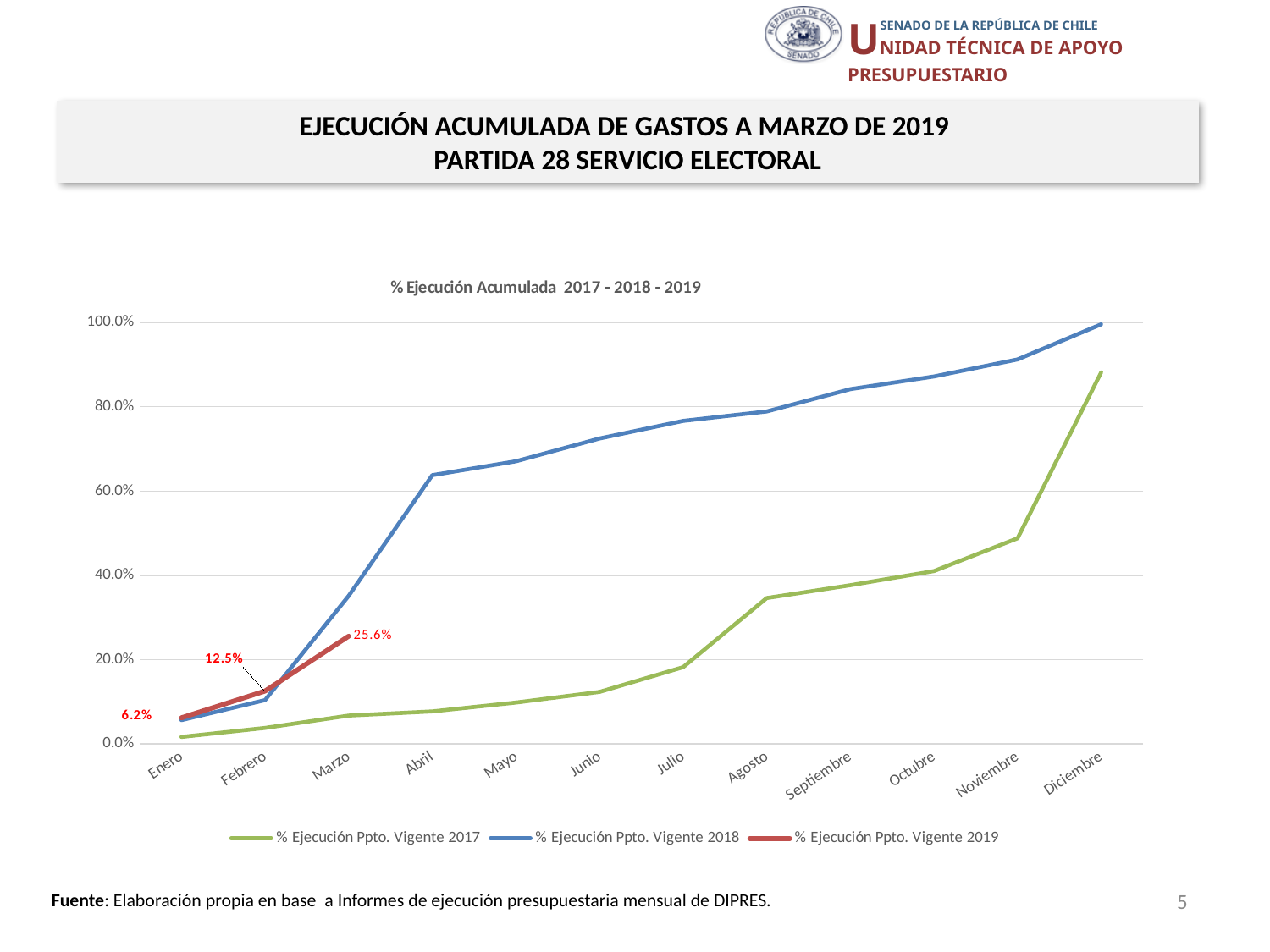
What kind of chart is shown on the slide? Line chart What is the value of % Ejecución Ppto. Vigente 2019 for Marzo? 25.6% What is the value of % Ejecución Ppto. Vigente 2019 for Febrero? 12.5% How many months are shown on the x axis? 12 How many series does the legend list? 3 What is the difference between the 2019 values for Febrero and Enero? 6.3% What is the difference between the 2019 values for Marzo and Febrero? 13.1% Which month has the highest value for % Ejecución Ppto. Vigente 2019? Marzo What is the value of % Ejecución Ppto. Vigente 2019 for Enero? 6.2% Is the value for % Ejecución Ppto. Vigente 2017 in Agosto greater or less than 40%? less In Diciembre, which series has the larger value: % Ejecución Ppto. Vigente 2017 or % Ejecución Ppto. Vigente 2018? % Ejecución Ppto. Vigente 2018 Does the % Ejecución Ppto. Vigente 2018 series rise or fall from Enero to Diciembre? Rise